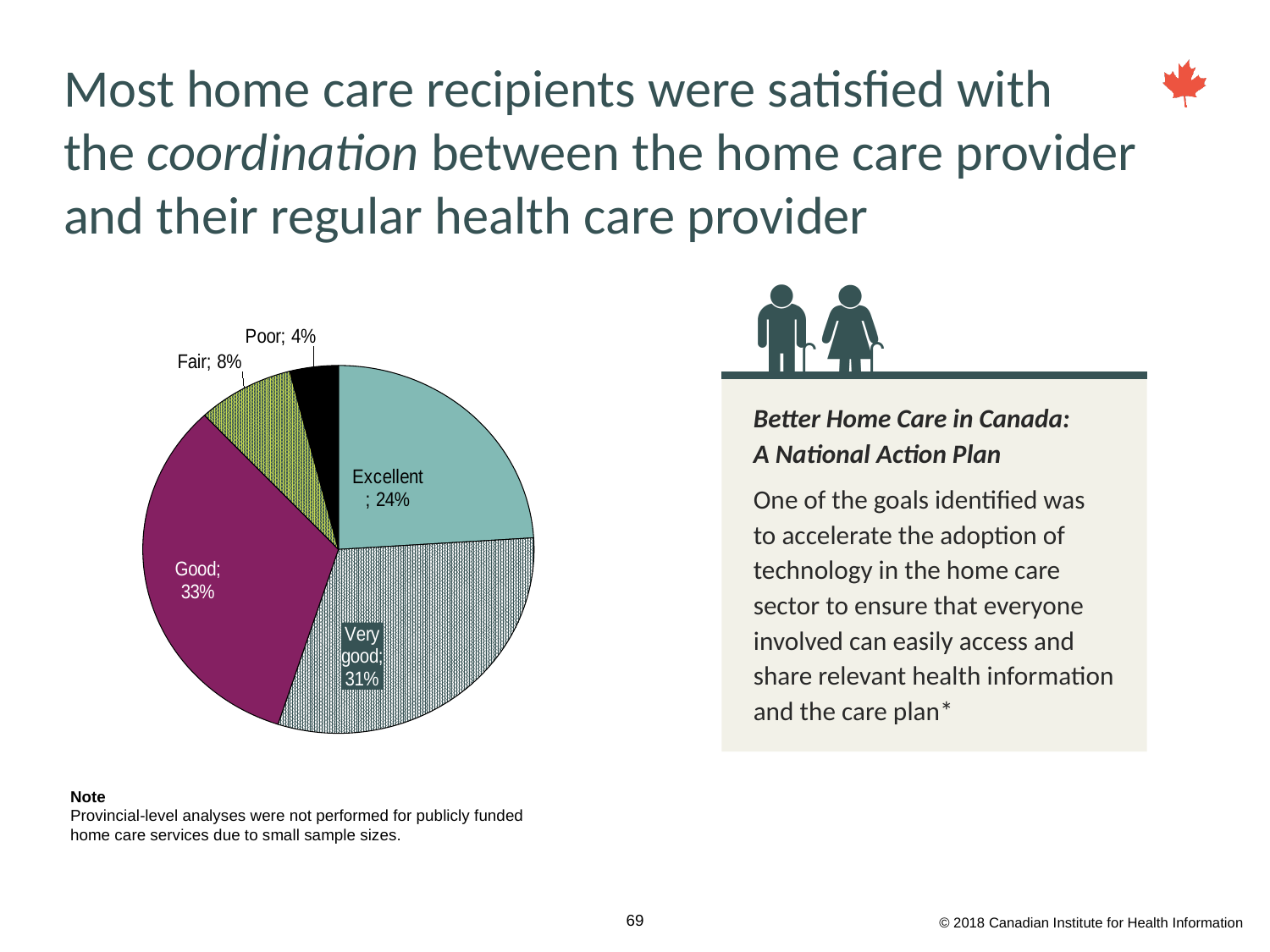
What percentage of home care recipients rated coordination as Fair? 8% What percentage of home care recipients rated coordination as Very good? 31% What percentage of home care recipients rated coordination as Excellent? 24% What kind of chart is shown on the slide? pie chart What percentage of home care recipients rated coordination as Good? 33% What is the combined share of the Excellent and Very good slices? 55% Which rating category has the largest share of the pie? Good Which slice is larger, Fair or Poor? Fair Which rating category has the smallest share of the pie? Poor How many slices does the pie chart have? 5 What is the difference in percentage points between the Good and Excellent slices? 9 What percentage of home care recipients rated coordination as Poor? 4%